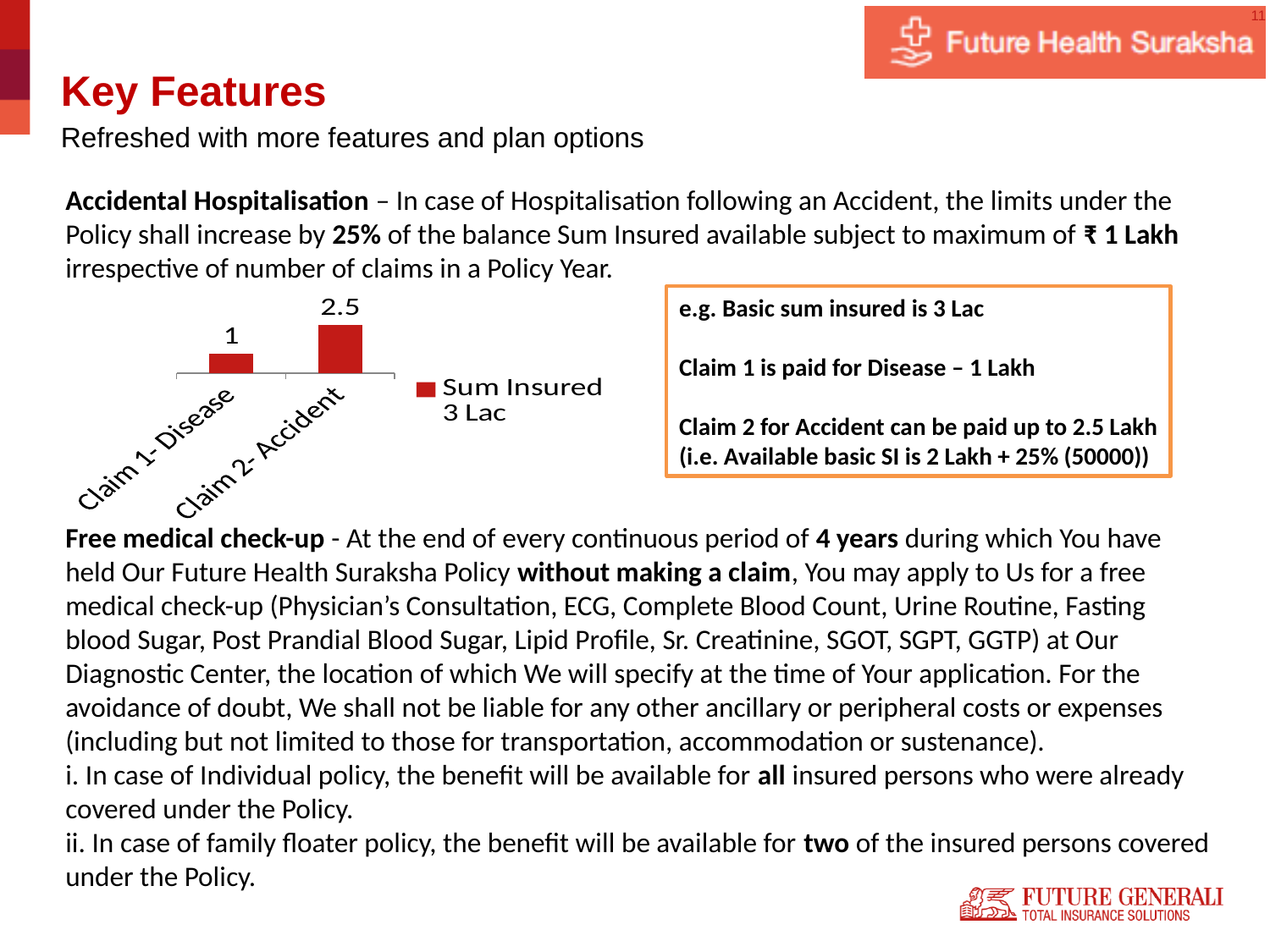
How many categories are shown in the chart? 2 What is the value for Claim 1- Disease? 1 What colour are the bars in the chart? Red Which category has the lowest value? Claim 1- Disease How many series does the legend list? 1 What is the value for Claim 2- Accident? 2.5 What is the name of the series shown in the legend? Sum Insured 3 Lac Which category has the highest value? Claim 2- Accident What kind of chart is shown on the slide? Bar chart Do the values rise or fall from Claim 1- Disease to Claim 2- Accident? Rise Which is larger, the value for Claim 1- Disease or Claim 2- Accident? Claim 2- Accident What is the difference between the values for Claim 2- Accident and Claim 1- Disease? 1.5